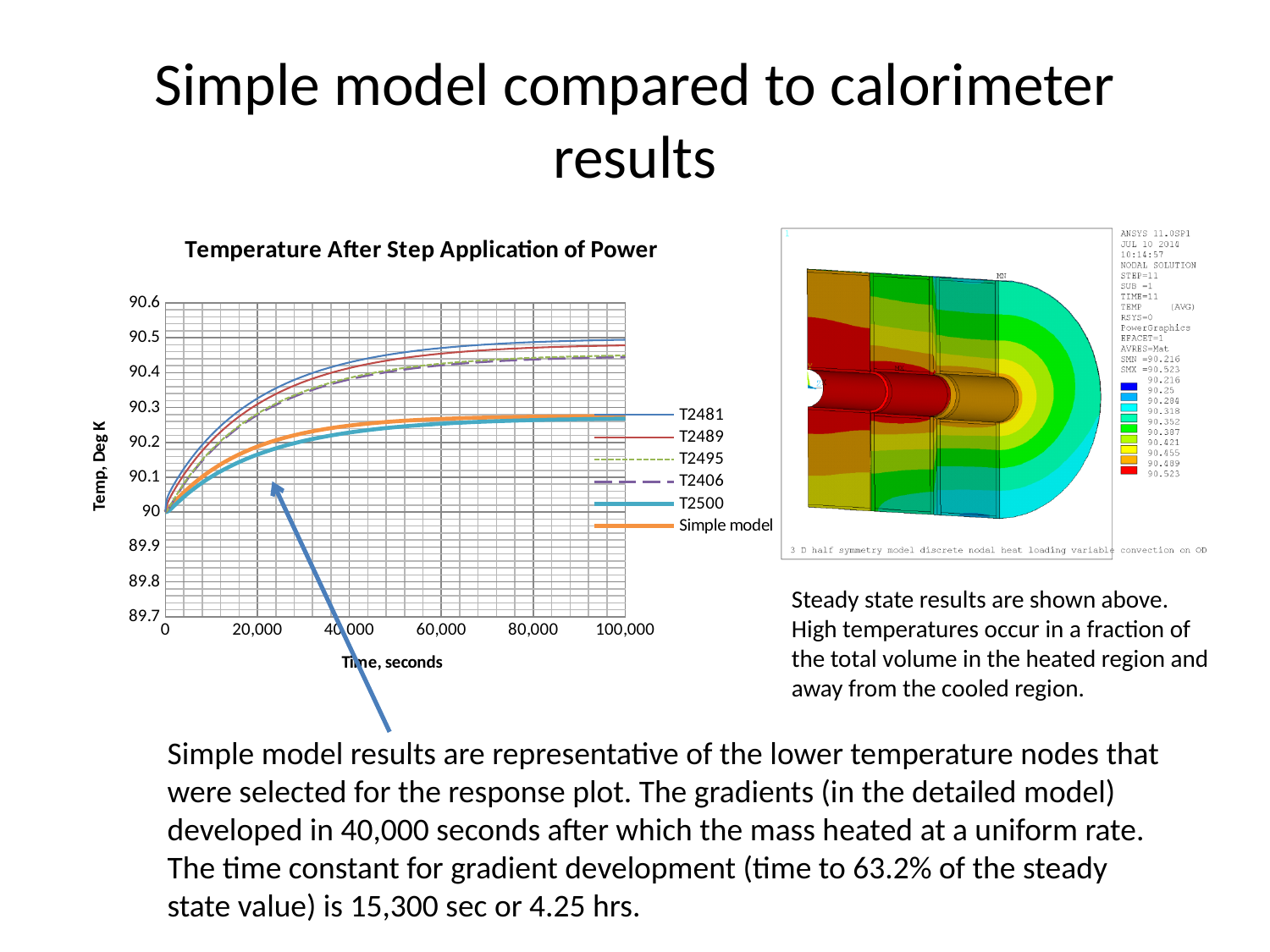
In the "Temperature After Step Application of Power" chart, which series reaches the highest temperature at 100,000 seconds? T2481 In the "Temperature After Step Application of Power" chart, is the value for T2489 at 20,000 seconds greater or less than 90.1? greater How many series does the legend of the "Temperature After Step Application of Power" chart list? 6 In the "Temperature After Step Application of Power" chart, is the value for T2481 at 100,000 seconds greater or less than 90.4? greater In the "Temperature After Step Application of Power" chart, do the temperatures rise or fall as time increases? rise What is the label of the x axis in the "Temperature After Step Application of Power" chart? Time, seconds In the "Temperature After Step Application of Power" chart, which is higher at 100,000 seconds, T2481 or T2500? T2481 In the "Temperature After Step Application of Power" chart, which is higher at 60,000 seconds, T2489 or Simple model? T2489 What kind of chart is "Temperature After Step Application of Power"? line chart In the "Temperature After Step Application of Power" chart, is the value for T2500 at 100,000 seconds greater or less than 90.2? greater What is the label of the y axis in the "Temperature After Step Application of Power" chart? Temp, Deg K